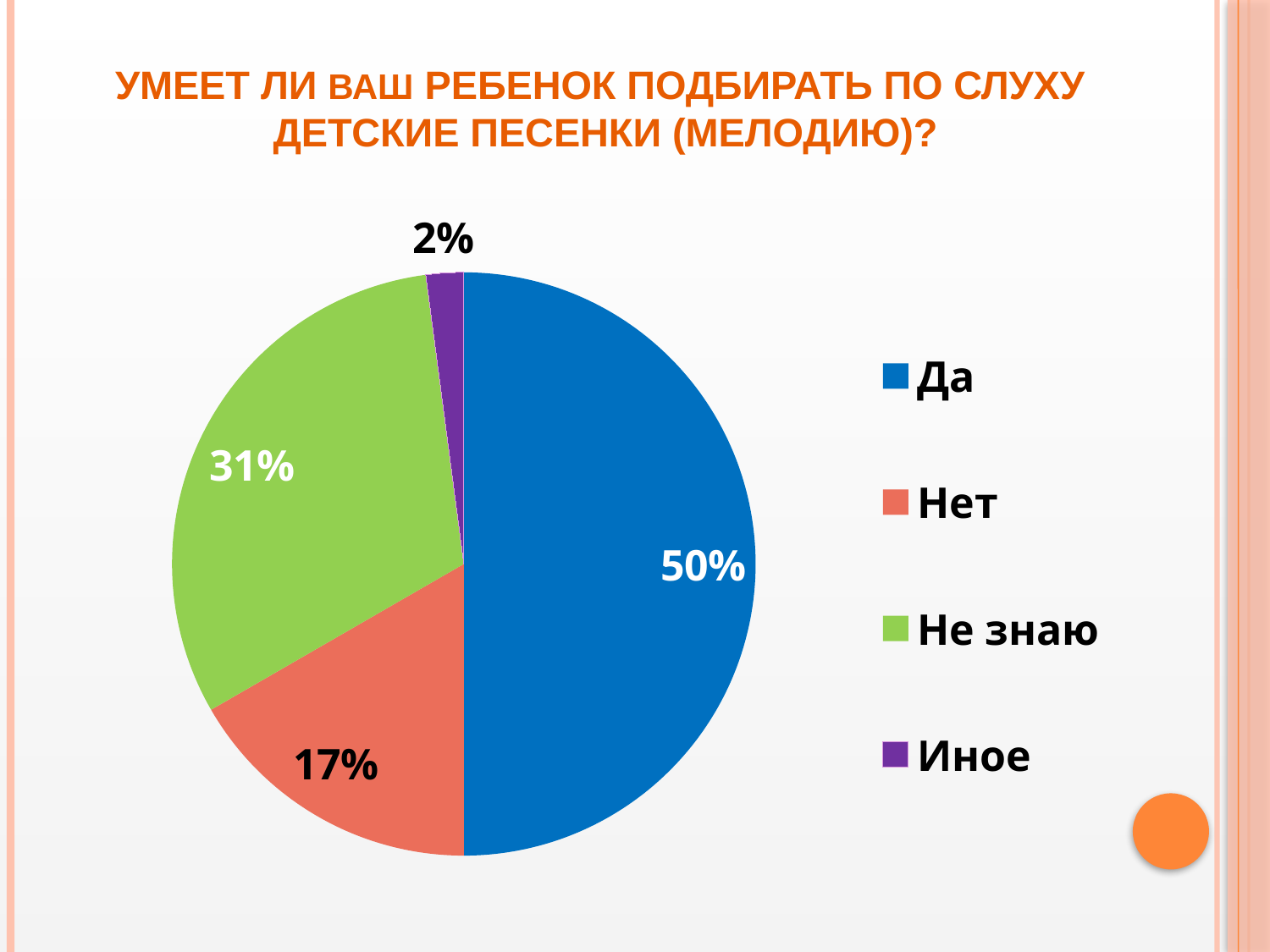
Which is larger, the slice for "Нет" or the slice for "Не знаю"? Не знаю What kind of chart is shown on the slide? pie chart What share of the pie is labelled "Да"? 50% What share of the pie is labelled "Иное"? 2% What share of the pie is labelled "Не знаю"? 31% Which category has the smallest slice of the pie? Иное How many categories does the legend list? 4 Which category has the largest slice of the pie? Да What is the difference in percentage points between "Не знаю" and "Нет"? 14 What colour is the slice for "Не знаю"? green What is the difference in percentage points between "Да" and "Не знаю"? 19 What share of the pie is labelled "Нет"? 17%